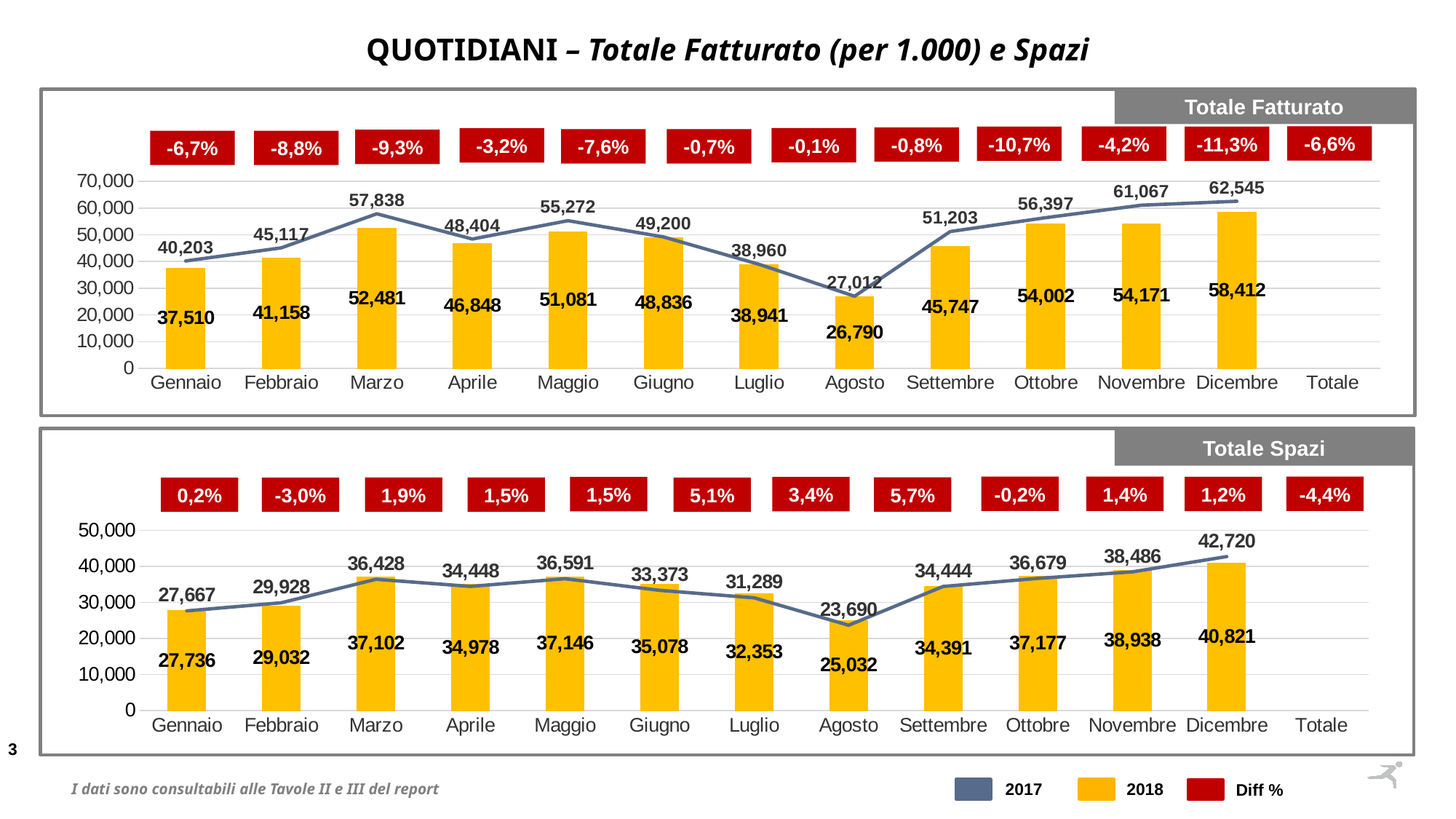
How many series does the legend at the bottom of the slide list? 3 In the Totale Spazi chart, which month has the highest 2018 value? Dicembre In the Totale Spazi chart, which is larger for Marzo: the 2017 value or the 2018 value? 2018 How many months are shown on the x axis of the Totale Fatturato chart (excluding Totale)? 12 In the Totale Fatturato chart, which month has the lowest 2018 value? Agosto In the Totale Fatturato chart, what is the Diff % shown for Totale? -6,6% In the Totale Spazi chart, what is the Diff % shown for Settembre? 5,7% In the Totale Fatturato chart, what is the difference between the 2017 and 2018 values for Dicembre? 4,133 In the Totale Fatturato chart, what is the 2017 value for Novembre? 61,067 In the Totale Spazi chart, what is the difference between the 2018 and 2017 values for Agosto? 1,342 In the Totale Spazi chart, is the 2018 bar for Agosto greater or less than 30,000? less In the Totale Fatturato chart, what is the 2018 value for Marzo? 52,481